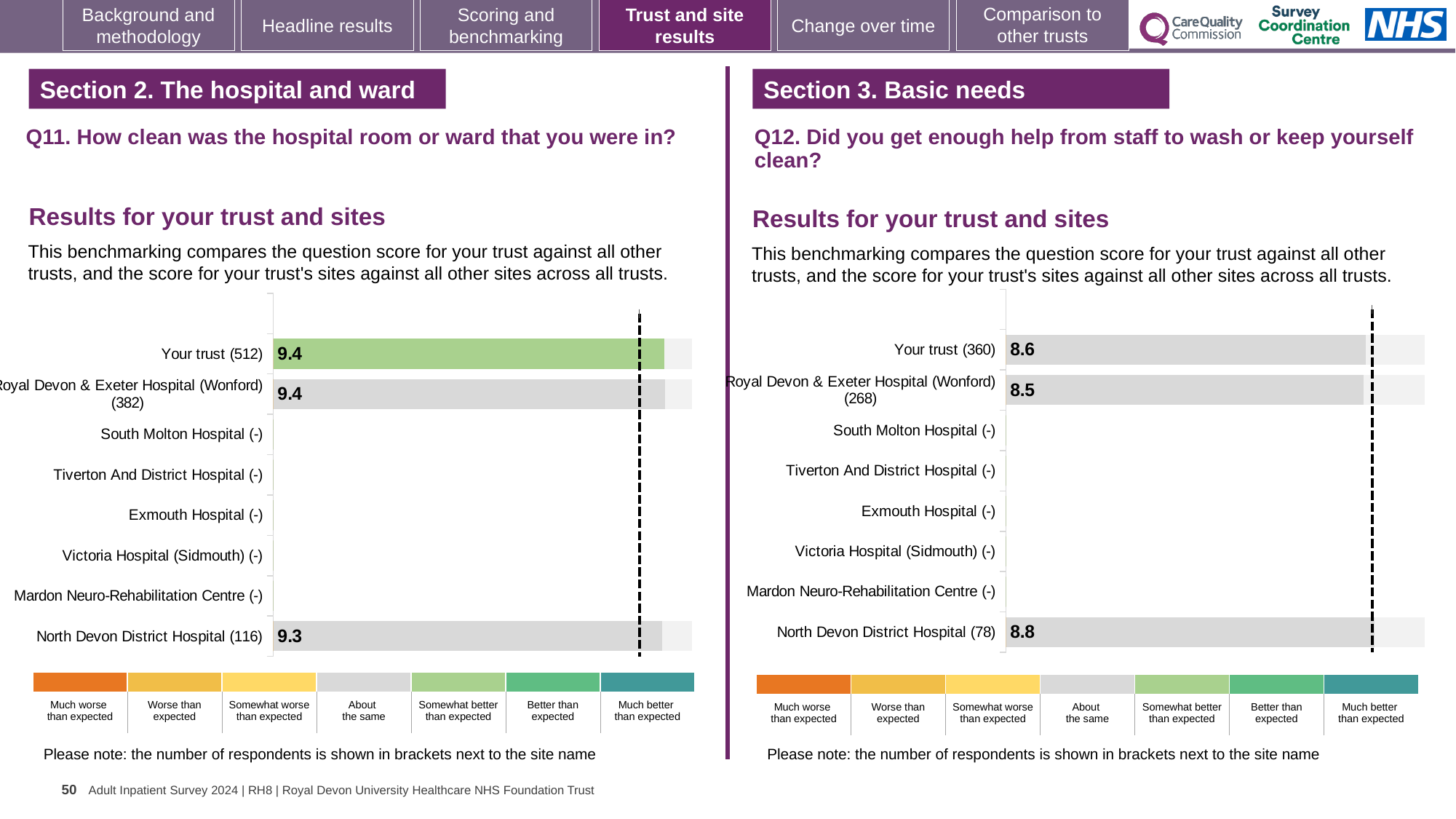
On the Q11 chart (left), what is the score for Your trust (512)? 9.4 On the Q12 chart (right), what is the score for North Devon District Hospital (78)? 8.8 On the Q12 chart (right), which is larger: the score for Your trust or the score for Royal Devon & Exeter Hospital (Wonford)? Your trust On the Q11 chart (left), what is the difference between the Your trust score and the North Devon District Hospital score? 0.1 On the Q12 chart (right), what is the difference between the North Devon District Hospital score and the Your trust score? 0.2 On the Q12 chart (right), what is the score for Royal Devon & Exeter Hospital (Wonford) (268)? 8.5 On the Q11 chart (left), what is the score for North Devon District Hospital (116)? 9.3 What type of chart is used for the Q11 results on the left? Bar chart How many site or trust rows are listed on the Q11 chart (left)? 8 On the Q12 chart (right), what is the score for Your trust (360)? 8.6 On the Q12 chart (right), which site or trust row has the highest score? North Devon District Hospital (78) On the Q12 chart (right), which site or trust row has the lowest score? Royal Devon & Exeter Hospital (Wonford) (268)